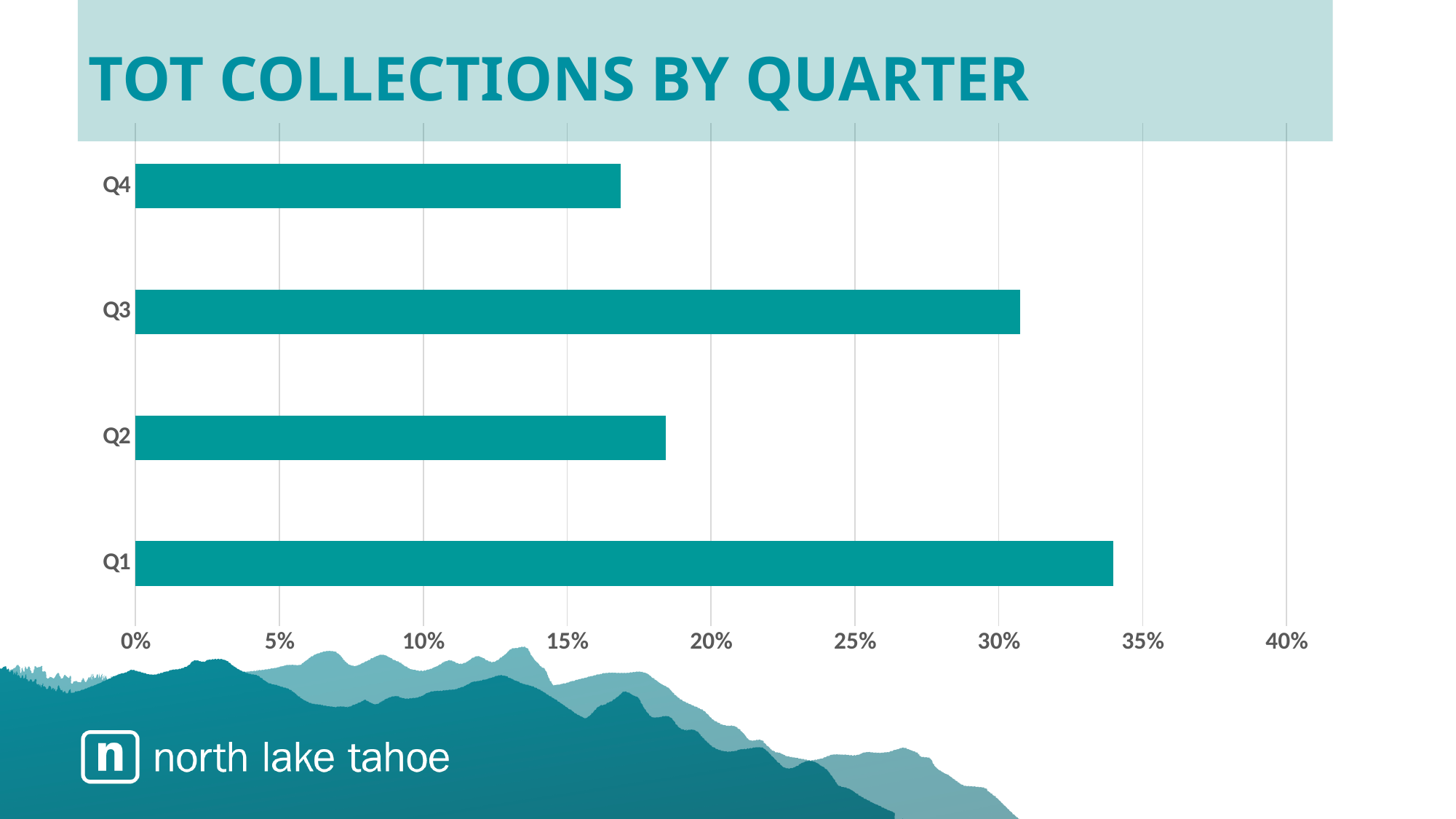
Which is larger, the value for Q2 or the value for Q4? Q2 Is the value for Q4 greater or less than 20%? less How many quarters are plotted in the chart? 4 Which quarter has the highest TOT collections share? Q1 Which is larger, the value for Q1 or the value for Q3? Q1 What is the highest value labelled on the horizontal axis? 40% What is the title of the chart? TOT COLLECTIONS BY QUARTER Which quarter has the lowest TOT collections share? Q4 Is the value for Q1 greater or less than 30%? greater Is the value for Q3 greater or less than 35%? less What kind of chart is shown on the slide? bar chart